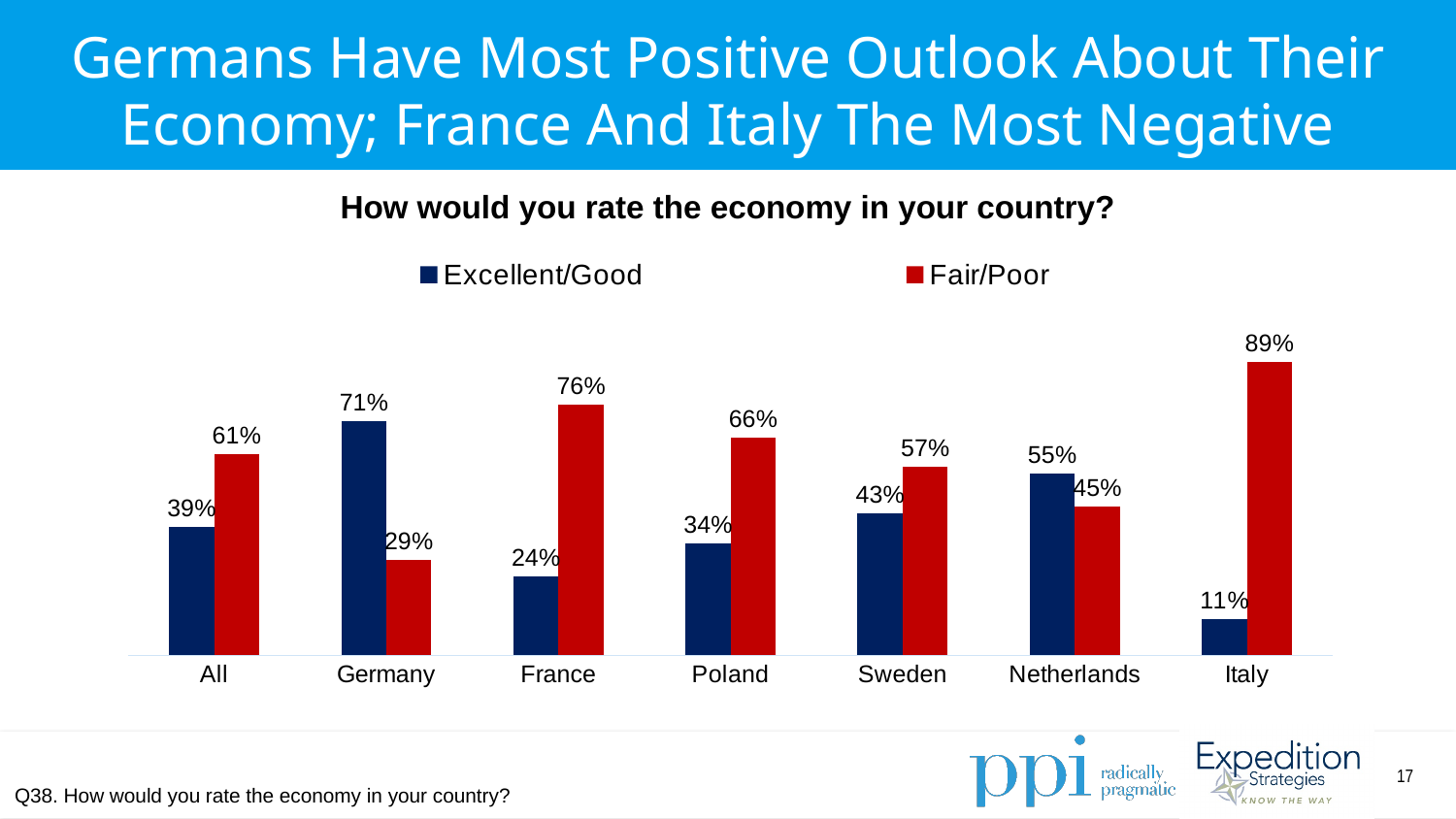
Which colour represents the Fair/Poor series? Red What percentage of respondents in Germany rate their economy as Excellent/Good? 71% Which country has the lowest Fair/Poor percentage? Germany Which country has the highest Excellent/Good percentage? Germany How many series does the legend list? 2 How many countries or groups are shown on the x axis? 7 Which country has the lowest Excellent/Good percentage? Italy What kind of chart is shown on the slide? Bar chart What is the Fair/Poor value for Italy? 89% What is the Excellent/Good value for France? 24% Which is larger for the Netherlands: Excellent/Good or Fair/Poor? Excellent/Good What is the difference between the Fair/Poor and Excellent/Good values for Poland? 32 percentage points